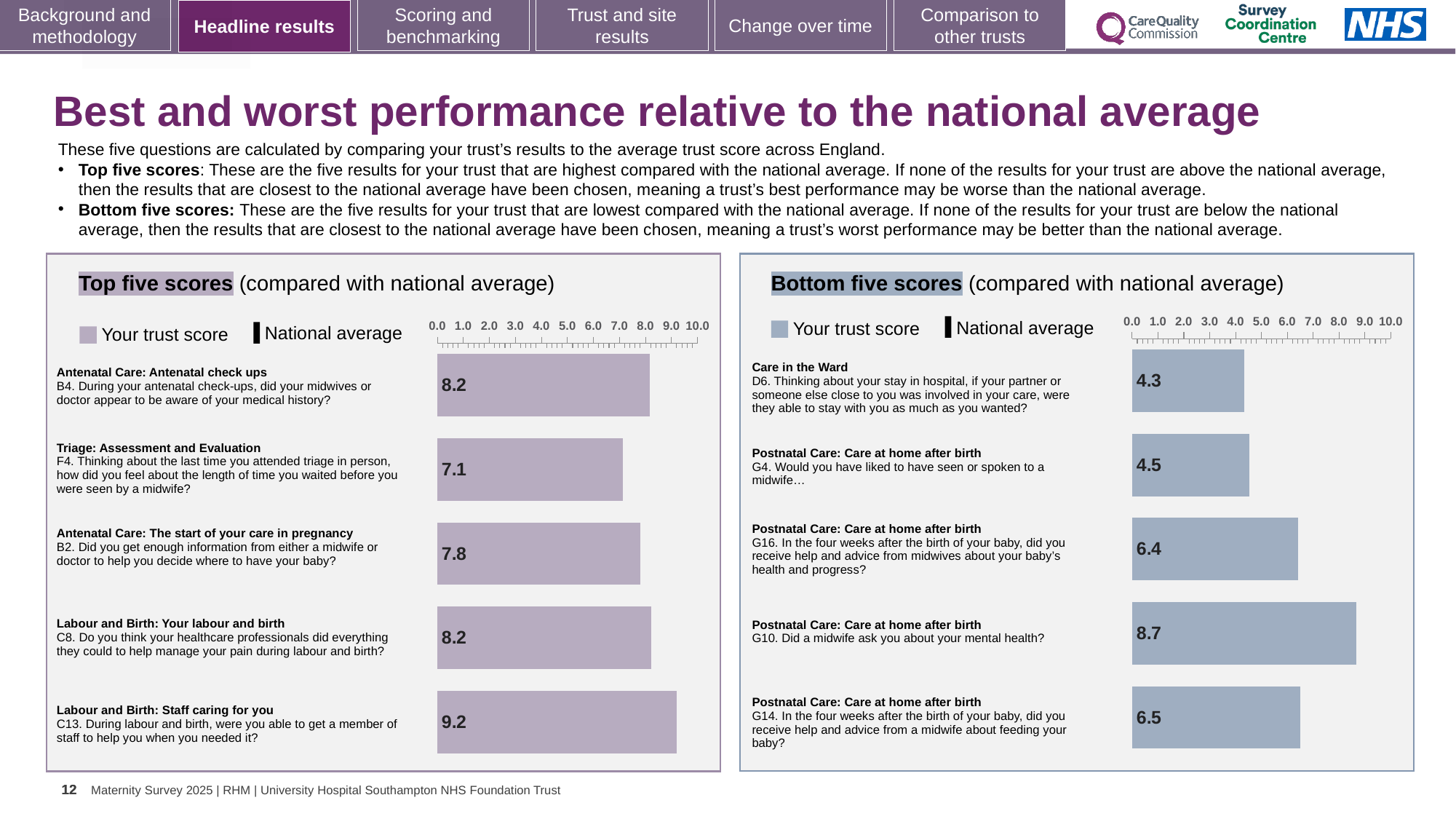
In the Bottom five scores chart, what is the difference between the trust scores for G10 and D6? 4.4 How many bars are shown in the Top five scores chart? 5 In the Top five scores chart, which question has the highest trust score? C13 (Labour and Birth: Staff caring for you) In the Bottom five scores chart, which question has the highest trust score? G10 (Postnatal Care: Care at home after birth) What type of chart is used in the Bottom five scores panel? Bar chart In the Bottom five scores chart, which has the larger trust score, G16 or G14? G14 (6.5) In the Bottom five scores chart, what is the trust score for G10 (Did a midwife ask you about your mental health?)? 8.7 In the Bottom five scores chart, which question has the lowest trust score? D6 (Care in the Ward) In the Top five scores chart, what is the trust score for B2 (Antenatal Care: The start of your care in pregnancy)? 7.8 In the Top five scores chart, what is the difference between the trust scores for C13 and F4? 2.1 In the Top five scores chart, which question has the lowest trust score? F4 (Triage: Assessment and Evaluation) In the Top five scores chart, what is the trust score for C13 (Labour and Birth: Staff caring for you)? 9.2